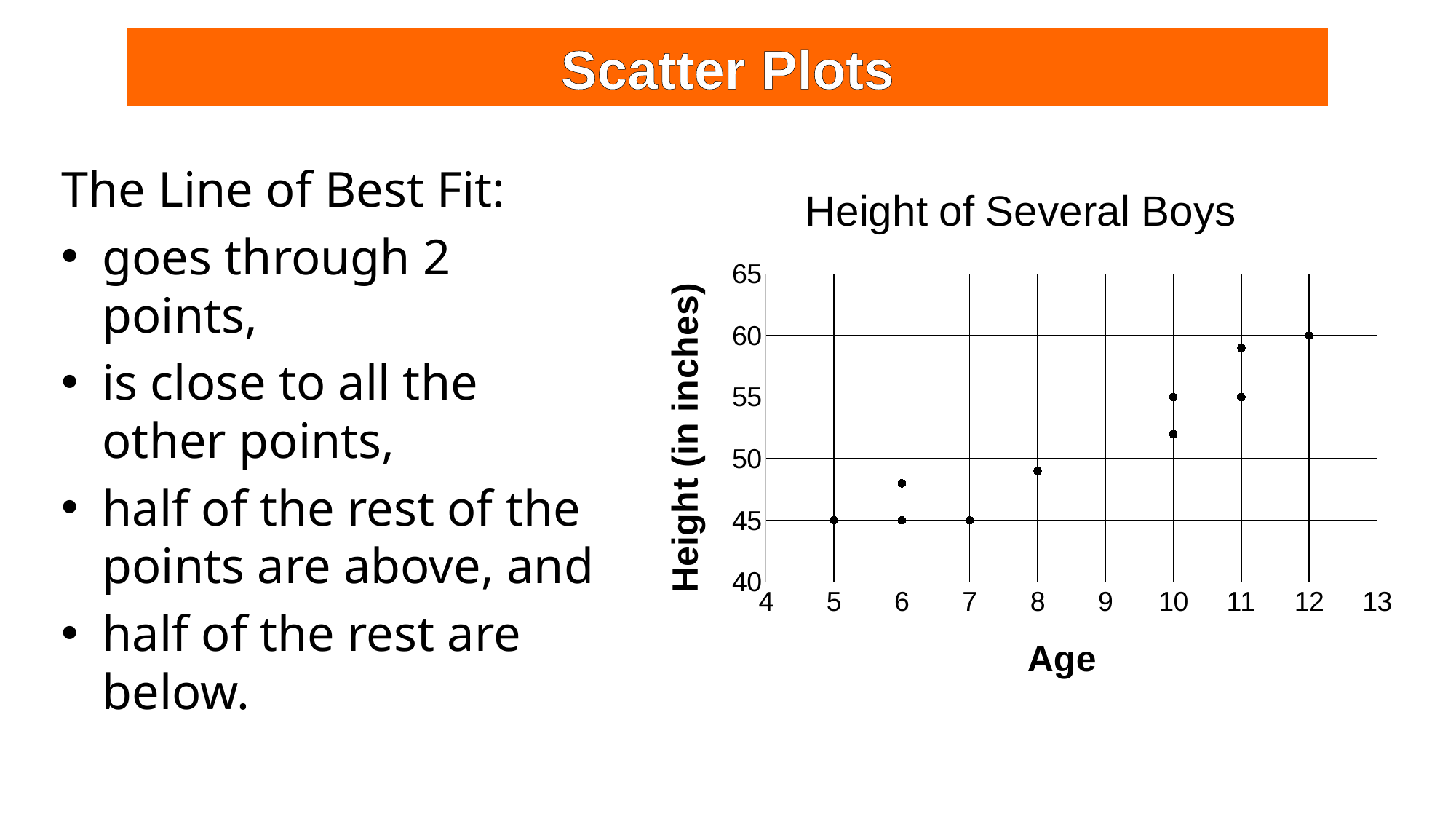
Is the taller boy aged 11 greater or less than 55 inches? greater What is the height plotted for the boy aged 7? 45 What kind of chart is shown on the slide? scatter plot What is the label of the vertical axis of the chart? Height (in inches) Do the heights generally rise or fall as age increases? rise What is the difference in height between the boy aged 12 and the boy aged 5? 15 What is the height plotted for the boy aged 5? 45 Which age has the highest plotted height? 12 What is the height plotted for the boy aged 12? 60 What is the title of the chart? Height of Several Boys How many data points are plotted on the chart? 10 Is the height of the boy aged 8 greater or less than 50? less